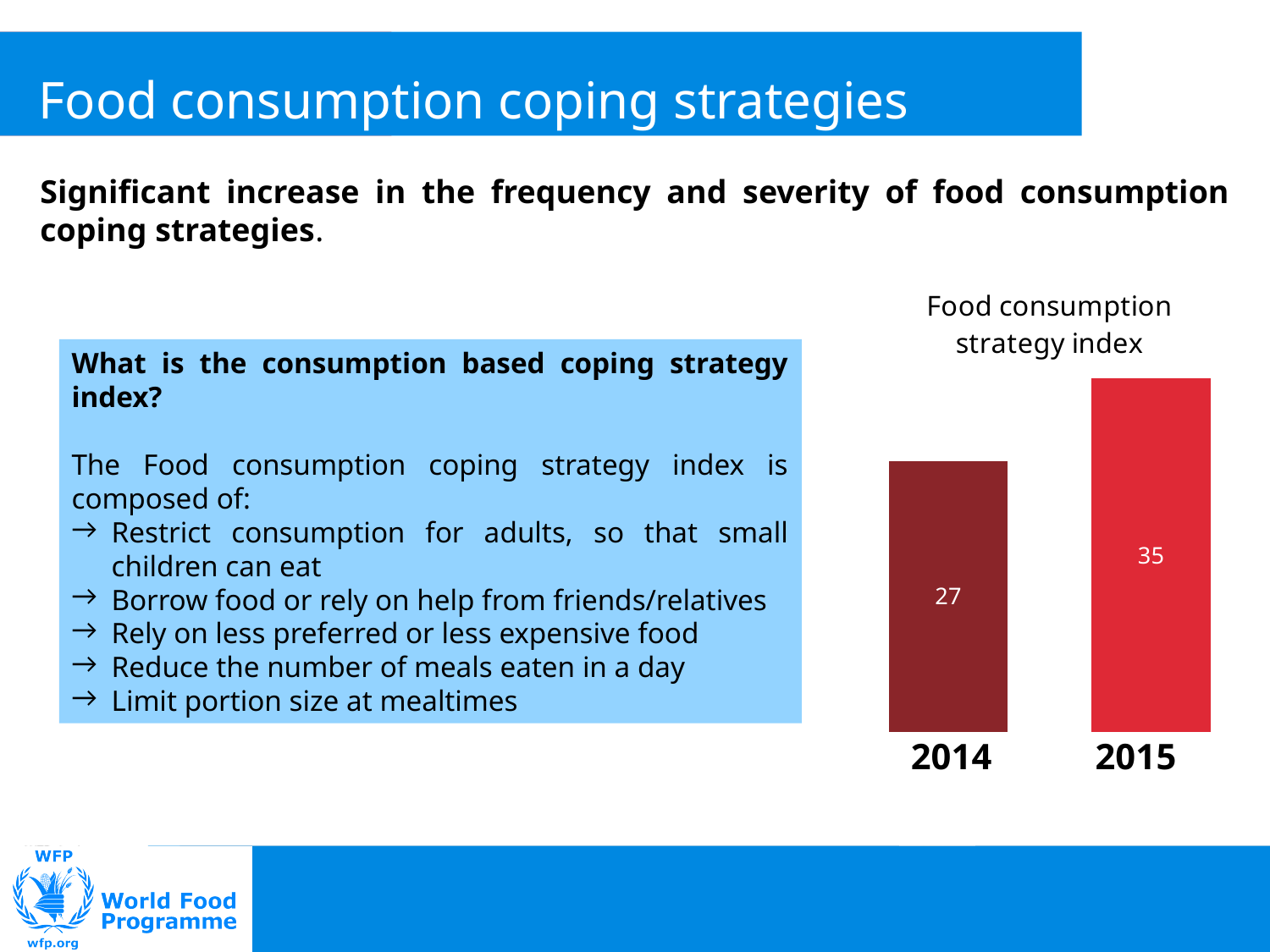
What kind of chart is used to show the Food consumption strategy index? Bar chart Which year has the higher Food consumption strategy index? 2015 What is the Food consumption strategy index value for 2015? 35 What is the title of the chart on the slide? Food consumption strategy index Is the Food consumption strategy index larger in 2014 or 2015? 2015 What is the Food consumption strategy index value for 2014? 27 By how much did the Food consumption strategy index increase from 2014 to 2015? 8 How many years are shown in the Food consumption strategy index chart? 2 Which year has the lower Food consumption strategy index? 2014 Does the Food consumption strategy index rise or fall from 2014 to 2015? Rise Which year's bar is shown in the brighter red colour in the chart? 2015